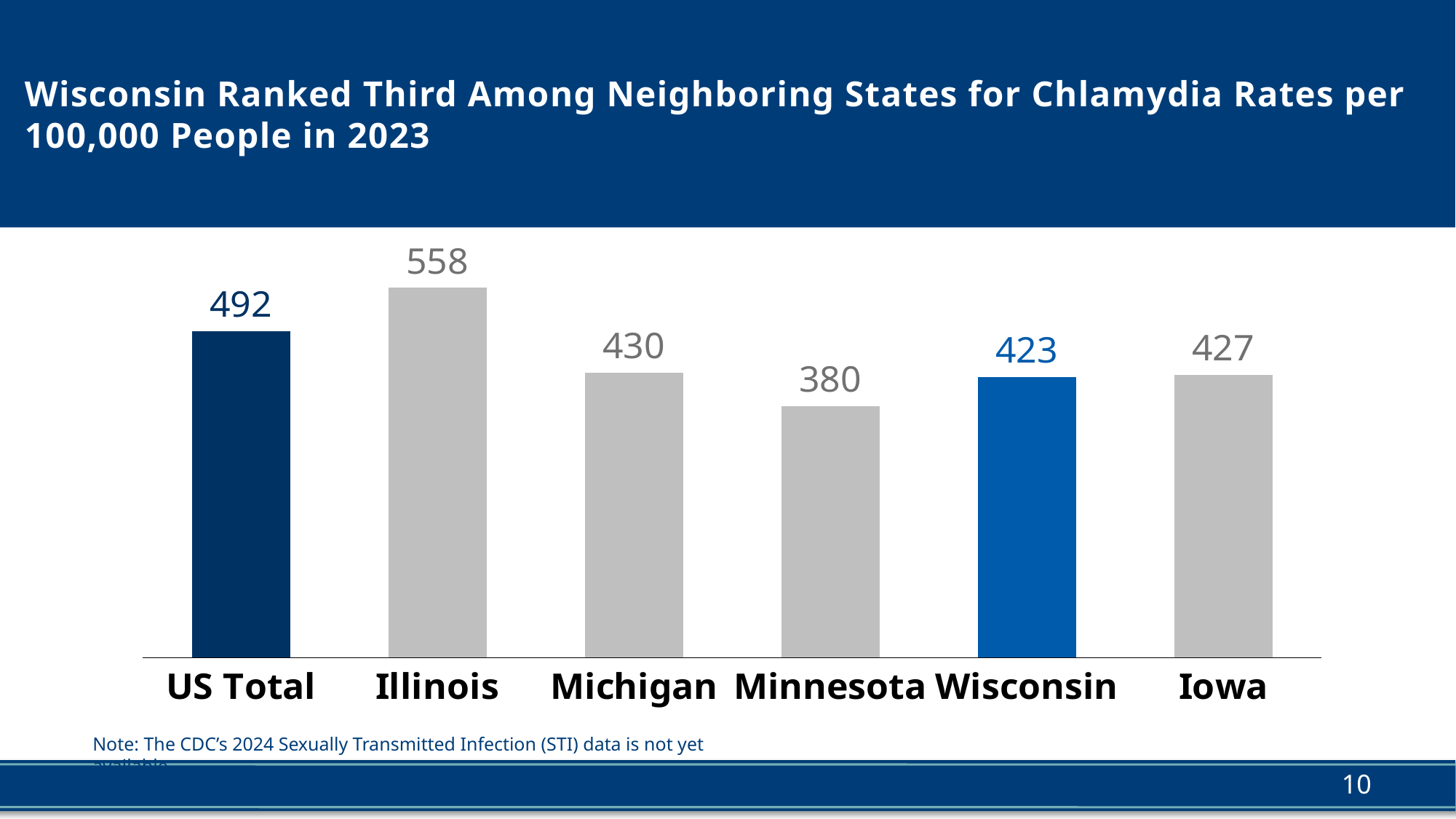
What is the value shown for Minnesota? 380 How many bars are shown in the chart? 6 What kind of chart is shown on the slide? Bar chart What is the value shown for Illinois? 558 What is the chlamydia rate per 100,000 people for Wisconsin? 423 Which is larger, the value for Michigan or the value for Iowa? Michigan What is the value shown for US Total? 492 What is the difference between the values for Michigan and Minnesota? 50 What is the difference between the values for Illinois and Wisconsin? 135 Which category has the highest value? Illinois Which category has the lowest value? Minnesota Which bar is shown in a lighter blue colour than the others? Wisconsin